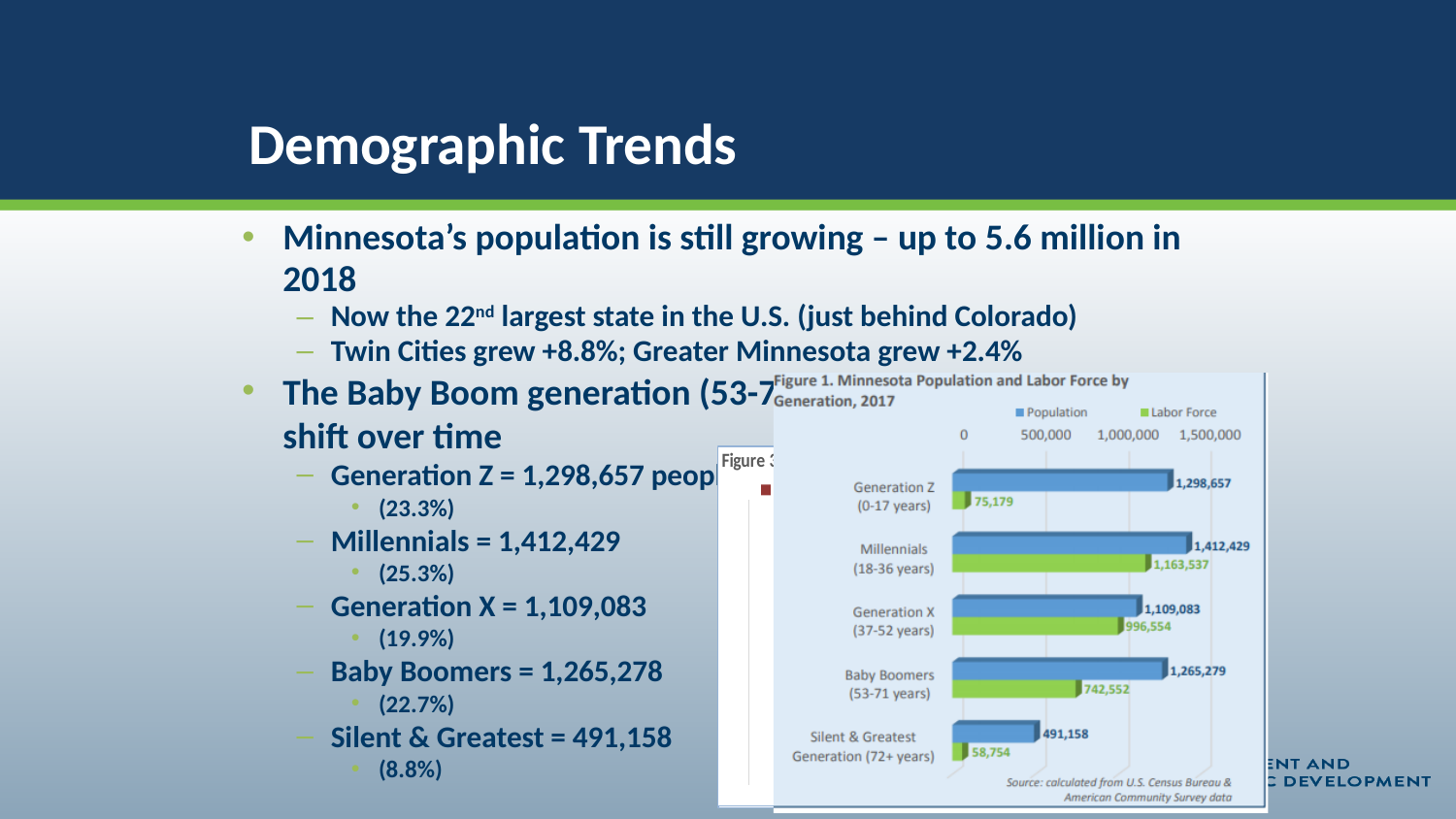
In the chart 'Figure 1. Minnesota Population and Labor Force by Generation, 2017', which colour represents the Labor Force series? Green In the chart 'Figure 1. Minnesota Population and Labor Force by Generation, 2017', what is the difference between the Population and Labor Force values for Generation X (37-52 years)? 112,529 How many series does the legend list in the chart 'Figure 1. Minnesota Population and Labor Force by Generation, 2017'? 2 In the chart 'Figure 1. Minnesota Population and Labor Force by Generation, 2017', what is the Population value for Millennials (18-36 years)? 1,412,429 In the chart 'Figure 1. Minnesota Population and Labor Force by Generation, 2017', which generation has the lowest Labor Force? Silent & Greatest Generation (72+ years) In the chart 'Figure 1. Minnesota Population and Labor Force by Generation, 2017', is the Labor Force value for Millennials greater or less than 1,000,000? greater In the chart 'Figure 1. Minnesota Population and Labor Force by Generation, 2017', which is larger: the Population of Generation Z or the Population of Baby Boomers? Generation Z In the chart 'Figure 1. Minnesota Population and Labor Force by Generation, 2017', what is the Labor Force value for Baby Boomers (53-71 years)? 742,552 In the chart 'Figure 1. Minnesota Population and Labor Force by Generation, 2017', what is the Labor Force value for Generation Z (0-17 years)? 75,179 In the chart 'Figure 1. Minnesota Population and Labor Force by Generation, 2017', which generation has the highest Population? Millennials (18-36 years) What kind of chart is 'Figure 1. Minnesota Population and Labor Force by Generation, 2017'? Bar chart How many generation categories are shown in the chart 'Figure 1. Minnesota Population and Labor Force by Generation, 2017'? 5